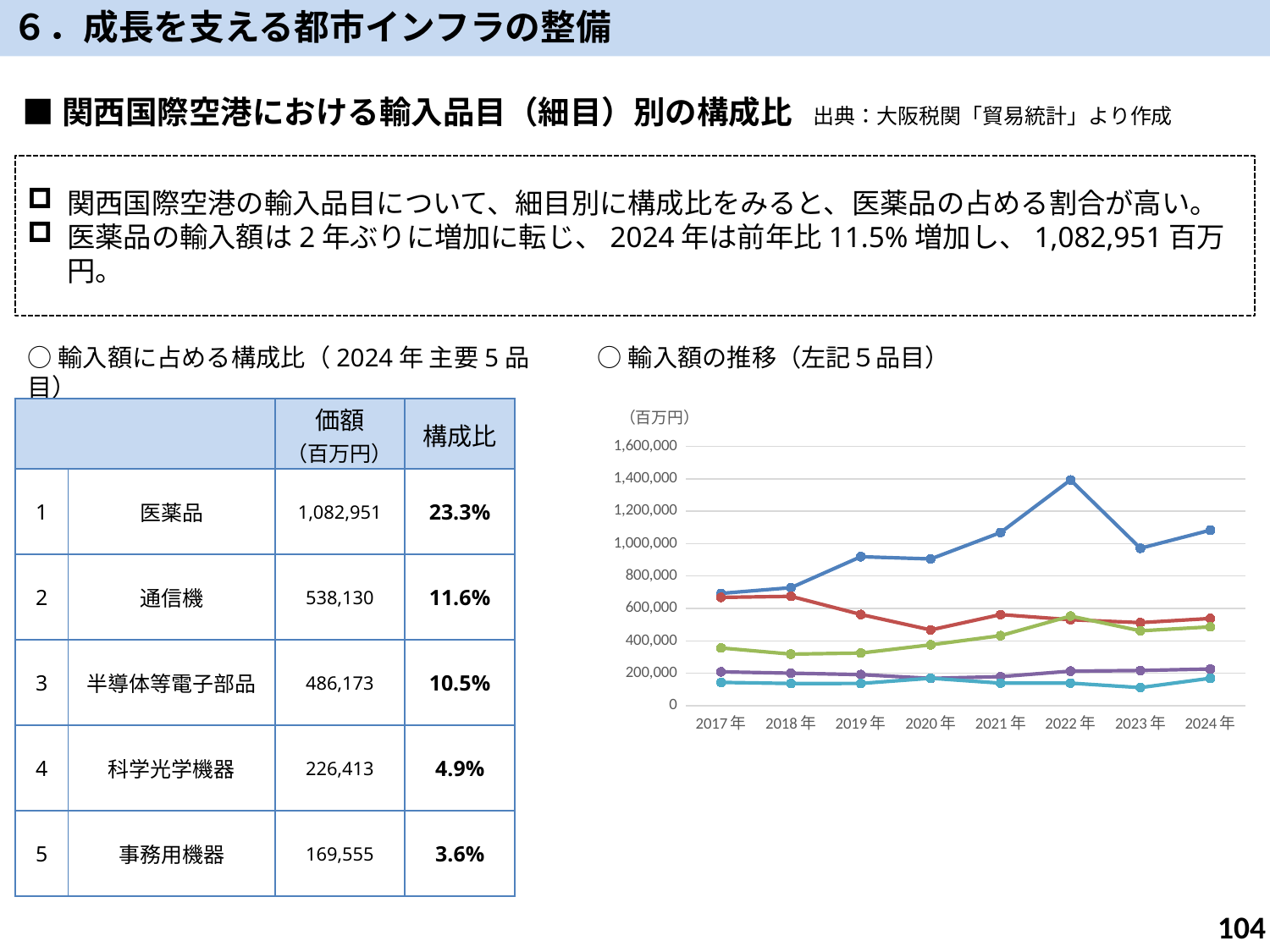
In the 輸入額の推移 chart, in which year does the blue line reach its highest value? 2022年 What kind of chart is the 輸入額の推移（左記5品目） chart? line chart How many years are shown on the x axis of the 輸入額の推移 chart? 8 In the 輸入額の推移 chart, does the blue line rise or fall from 2017年 to 2022年? rise In the 輸入額の推移 chart, which coloured line has the lowest value in 2023年? the light blue (cyan) line In the 輸入額の推移 chart, is the green line's value for 2017年 greater or less than 400,000? less How many lines are plotted in the 輸入額の推移 chart? 5 In the 輸入額の推移 chart, is the blue line's value for 2022年 greater or less than 1,200,000? greater In the 輸入額の推移 chart, is the blue line's value for 2024年 greater or less than 1,000,000? greater What unit is shown above the y axis of the 輸入額の推移 chart? 百万円 In the 輸入額の推移 chart, is the red line higher in 2017年 or in 2024年? 2017年